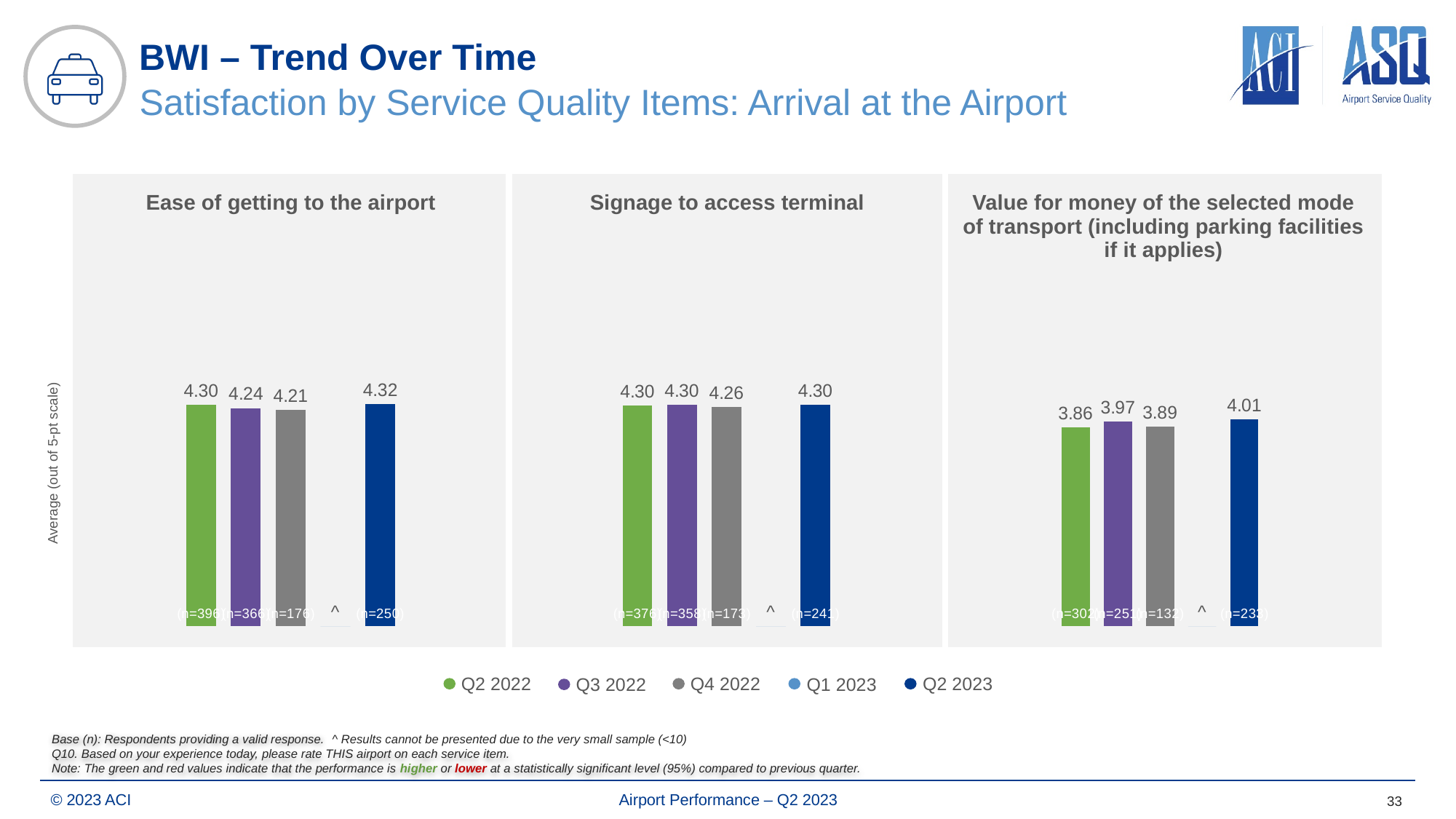
In the 'Ease of getting to the airport' chart, which quarter has the lowest value? Q4 2022 How many series does the legend list? 5 What kind of chart is used on this slide? Bar chart In the 'Signage to access terminal' chart, what is the value for Q4 2022? 4.26 In the 'Ease of getting to the airport' chart, what is the value for Q4 2022? 4.21 In the 'Value for money of the selected mode of transport' chart, what is the value for Q2 2022? 3.86 In the 'Signage to access terminal' chart, what is the difference between the Q3 2022 and Q4 2022 values? 0.04 Which quarter in the legend has no bar shown in any of the three charts? Q1 2023 In the 'Value for money of the selected mode of transport' chart, which is larger: the Q3 2022 value or the Q4 2022 value? Q3 2022 In the 'Value for money of the selected mode of transport' chart, which quarter has the highest value? Q2 2023 In the 'Value for money of the selected mode of transport' chart, what is the difference between the Q2 2023 and Q2 2022 values? 0.15 In the 'Ease of getting to the airport' chart, what is the value for Q2 2023? 4.32